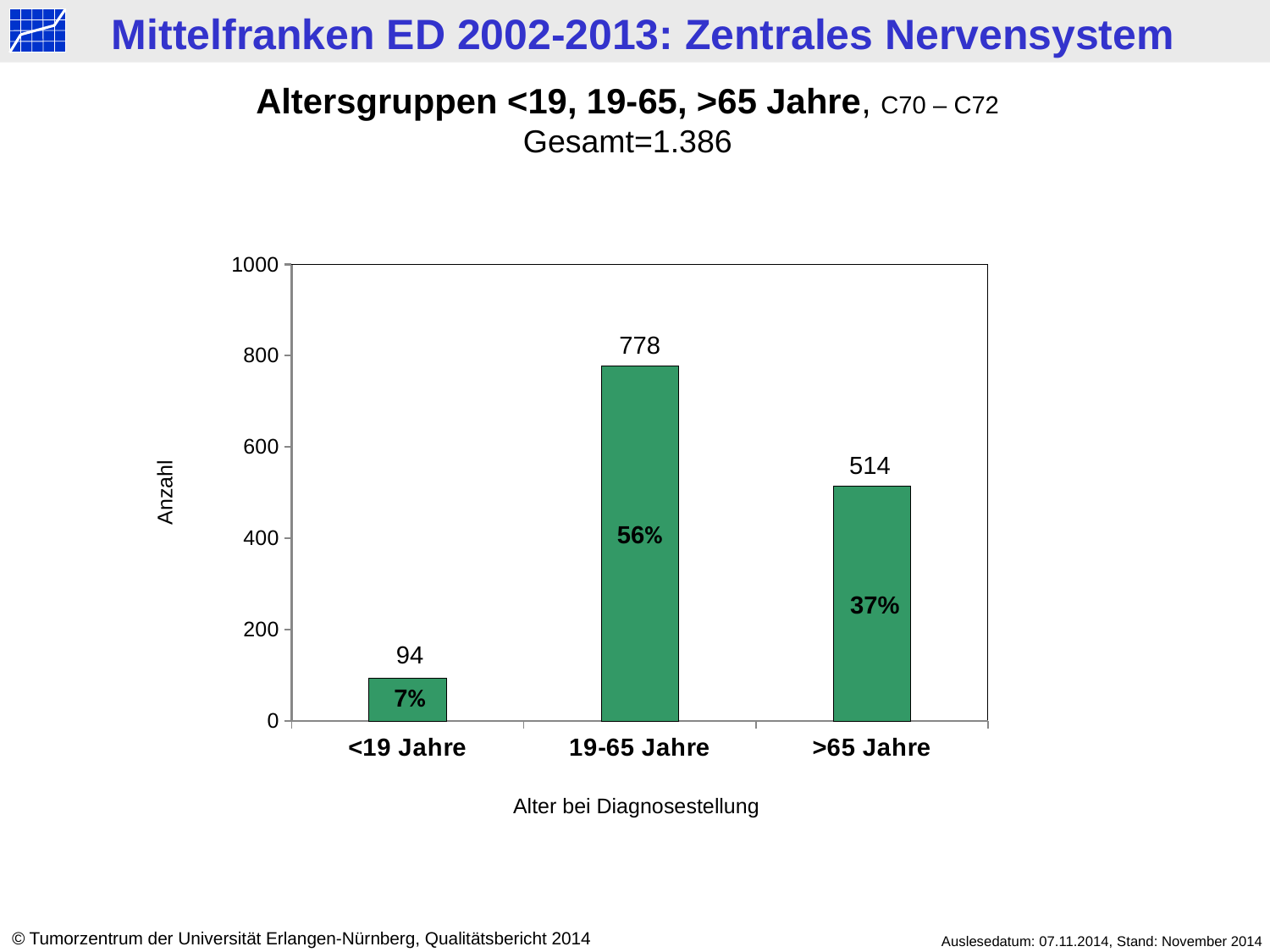
Which is larger, the value for >65 Jahre or the value for <19 Jahre? >65 Jahre Which age group has the highest value? 19-65 Jahre Which age group has the lowest value? <19 Jahre What is the difference between the values for 19-65 Jahre and >65 Jahre? 264 What is the value for the <19 Jahre age group? 94 Is the value for 19-65 Jahre greater or less than 600? greater What is the value for the 19-65 Jahre age group? 778 What percentage is shown on the bar for >65 Jahre? 37% What is the value for the >65 Jahre age group? 514 What kind of chart is shown on the slide? bar chart What is the label of the y axis? Anzahl How many age groups are shown on the x axis? 3